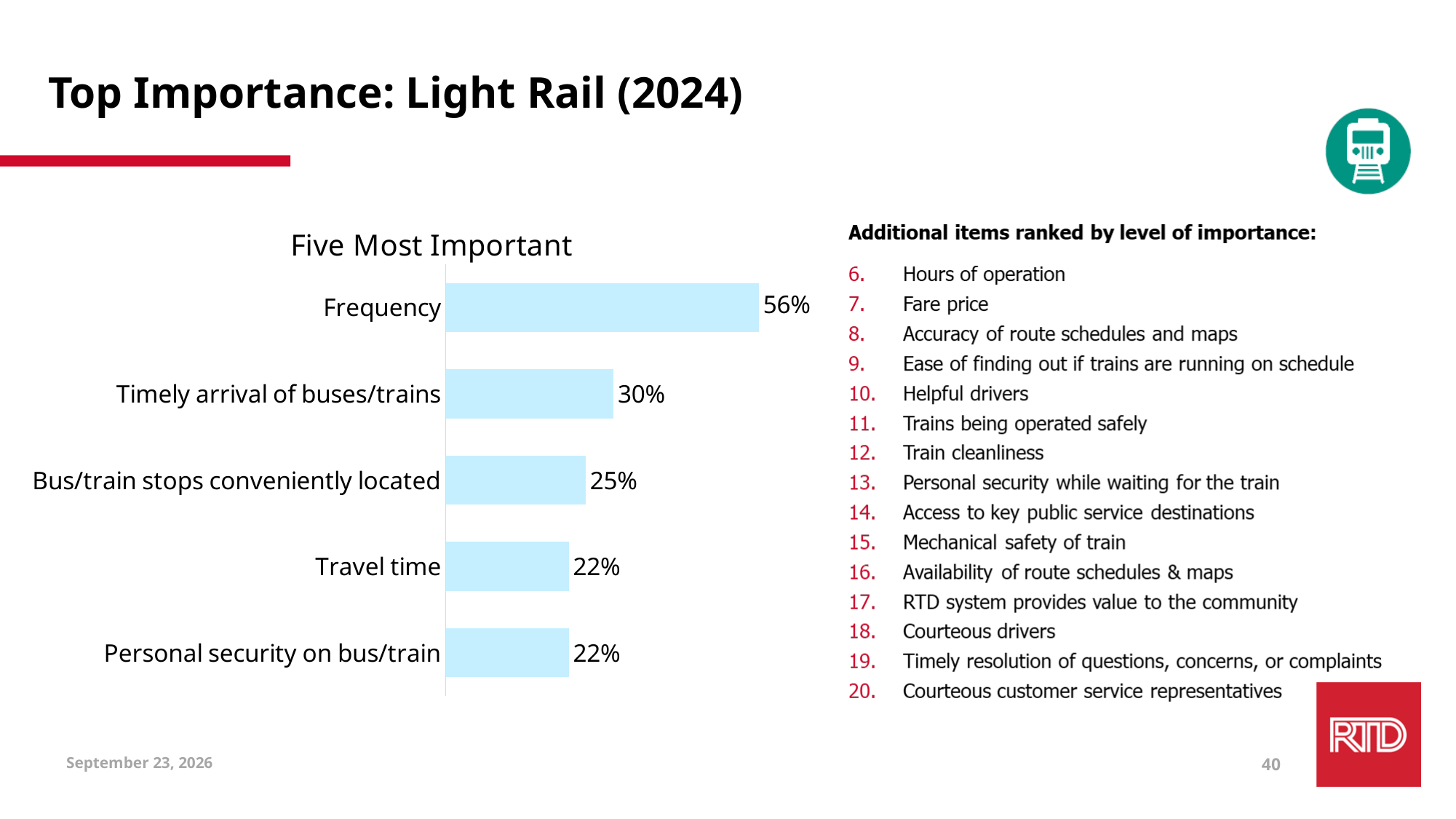
What is the difference between the values for Frequency and Timely arrival of buses/trains? 26% What is the value for Frequency? 56% Which is larger, the value for Timely arrival of buses/trains or the value for Bus/train stops conveniently located? Timely arrival of buses/trains How many categories are shown in the chart? 5 What is the value for Timely arrival of buses/trains? 30% Do the values for Travel time and Personal security on bus/train have the same value? Yes What kind of chart is shown on the slide? Bar chart What is the value for Bus/train stops conveniently located? 25% What is the difference between the values for Bus/train stops conveniently located and Travel time? 3% Which category has the highest value? Frequency What is the value for Travel time? 22% What is the title of the chart? Five Most Important